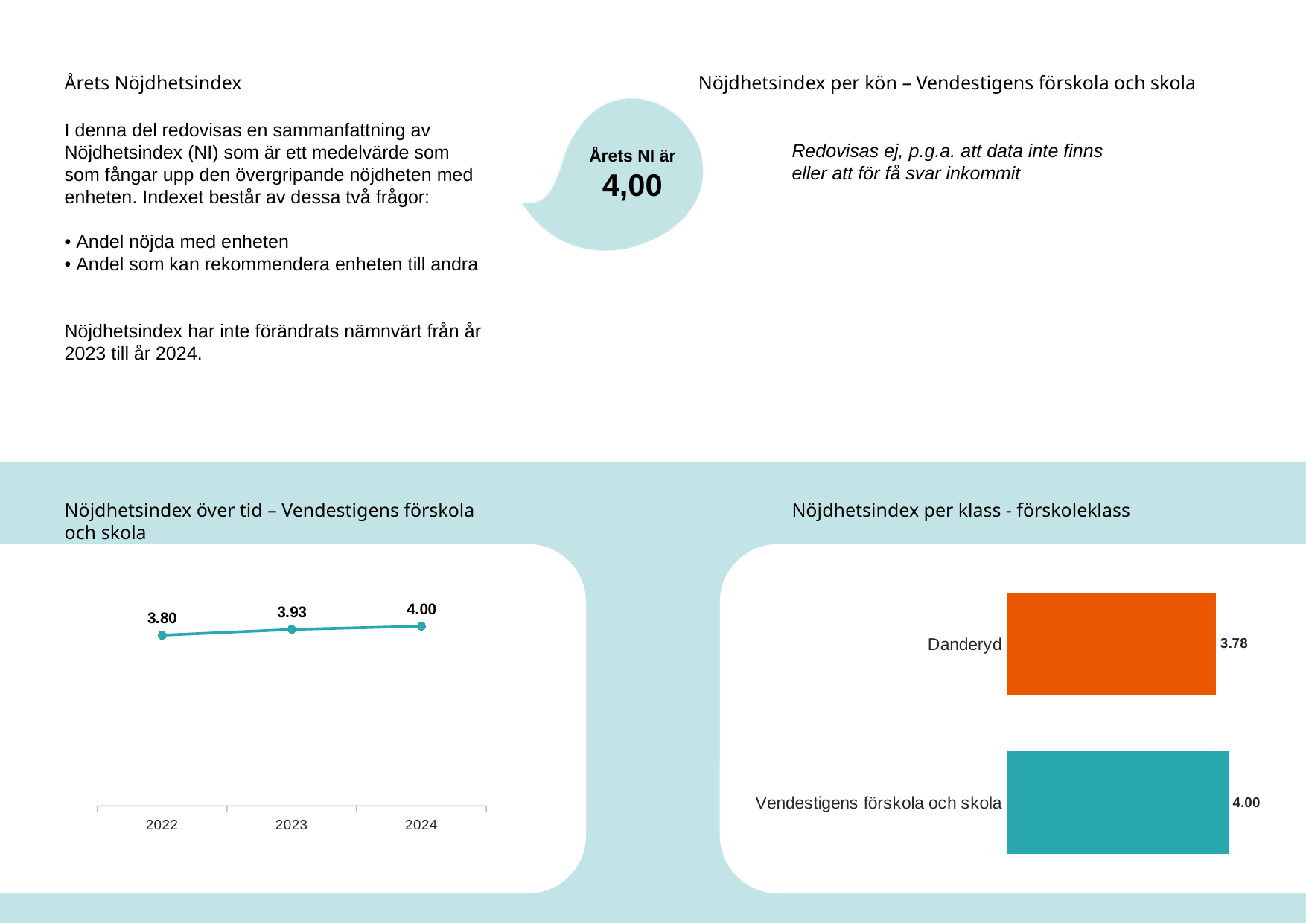
In the 'Nöjdhetsindex över tid' chart, which year has the highest value? 2024 In the 'Nöjdhetsindex över tid' chart, what is the value for 2024? 4.00 What kind of chart is the 'Nöjdhetsindex över tid' chart? line chart In the 'Nöjdhetsindex över tid' chart, do the values rise or fall from 2022 to 2024? rise In the 'Nöjdhetsindex över tid' chart, what is the value for 2023? 3.93 What kind of chart is the 'Nöjdhetsindex per klass - förskoleklass' chart? bar chart In the 'Nöjdhetsindex över tid' chart, what is the difference between the 2024 and 2022 values? 0.20 In the 'Nöjdhetsindex över tid' chart, what is the value for 2022? 3.80 In the 'Nöjdhetsindex per klass - förskoleklass' chart, what is the value for Danderyd? 3.78 In the 'Nöjdhetsindex över tid' chart, which year has the lowest value? 2022 In the 'Nöjdhetsindex per klass - förskoleklass' chart, which is larger, Danderyd or Vendestigens förskola och skola? Vendestigens förskola och skola In the 'Nöjdhetsindex över tid' chart, how many years are plotted? 3